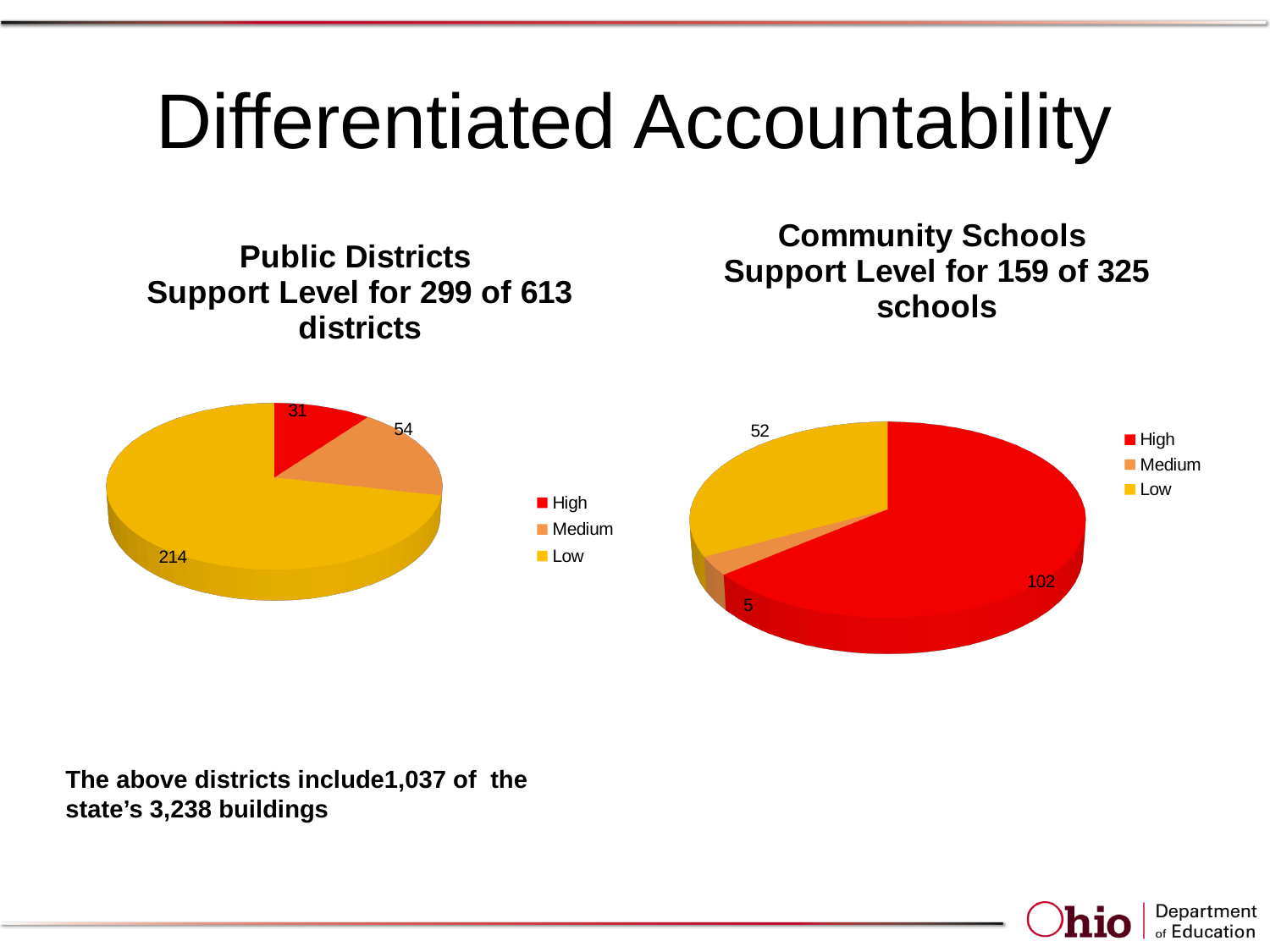
How many categories does the Public Districts pie chart have? 3 In the Community Schools chart, which support level has the smallest slice? Medium In the Community Schools chart, is the High slice or the Low slice larger? High In the Public Districts chart, how many districts are at the Low support level? 214 What type of chart is used for the Community Schools data? Pie chart In the Community Schools chart, how many schools are at the Medium support level? 5 In the Public Districts chart, how many districts are at the Medium support level? 54 In the Public Districts chart, which support level has the largest slice? Low In the Community Schools chart, what colour represents the Low support level? Yellow In the Community Schools chart, how many schools are at the High support level? 102 In the Public Districts chart, what is the difference between the Low and High values? 183 In the Community Schools chart, what is the difference between the High and Low values? 50